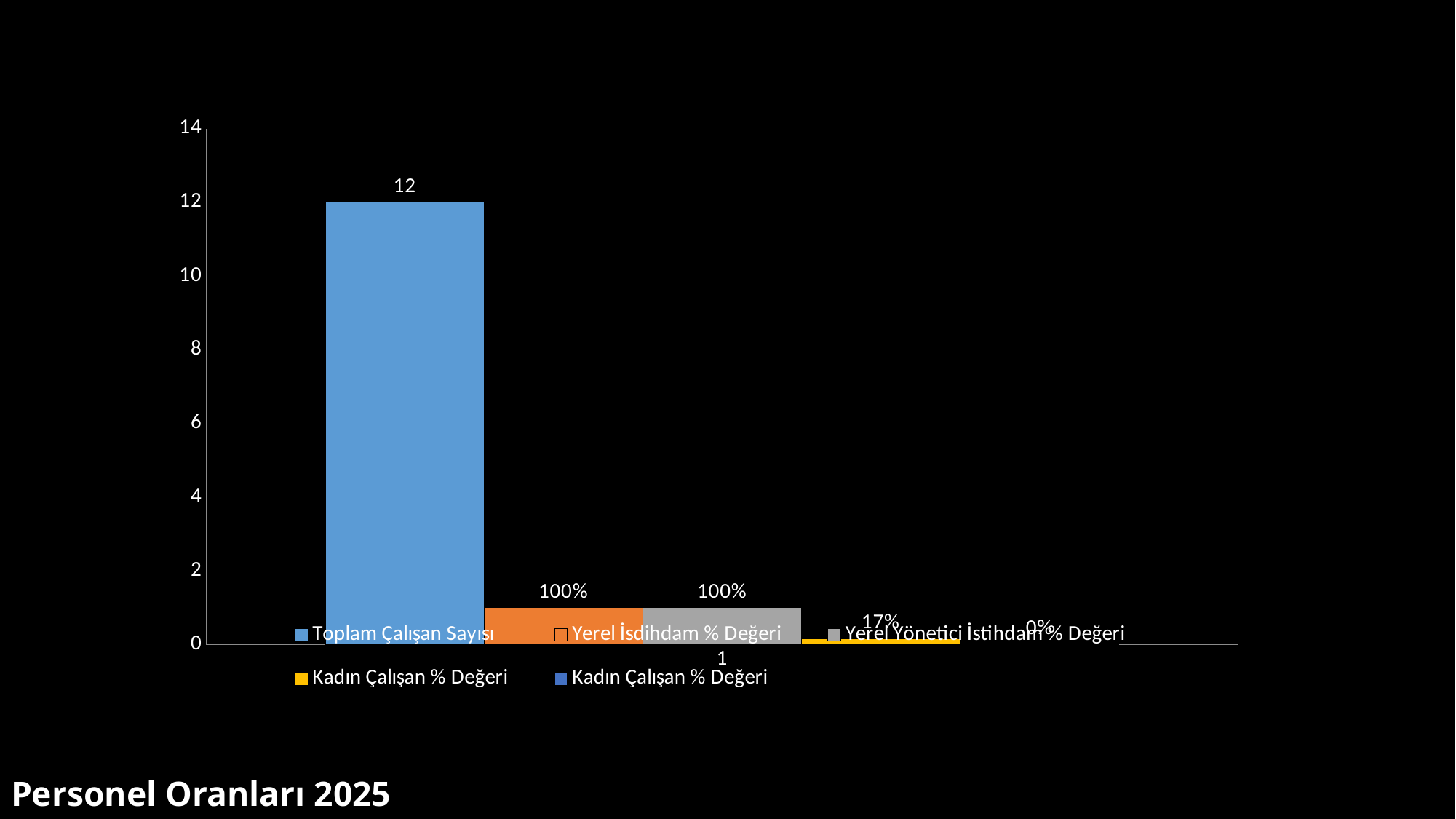
Which series has the tallest bar? Toplam Çalışan Sayısı What is the value for Yerel İstihdam % Değeri? 100% What is the highest tick value shown on the vertical axis? 14 What type of chart is shown on the slide? bar chart How many series does the legend list? 5 What colour is the Toplam Çalışan Sayısı bar? blue Which is larger, the value for Yerel İstihdam % Değeri or the value on the yellow Kadın Çalışan % Değeri bar? Yerel İstihdam % Değeri Is the value for Toplam Çalışan Sayısı greater or less than 10? greater What is the title of the chart? Personel Oranları 2025 What is the value for Yerel Yönetici İstihdam % Değeri? 100% What is the value labelled on the yellow Kadın Çalışan % Değeri bar? 17% What is the value for Toplam Çalışan Sayısı? 12